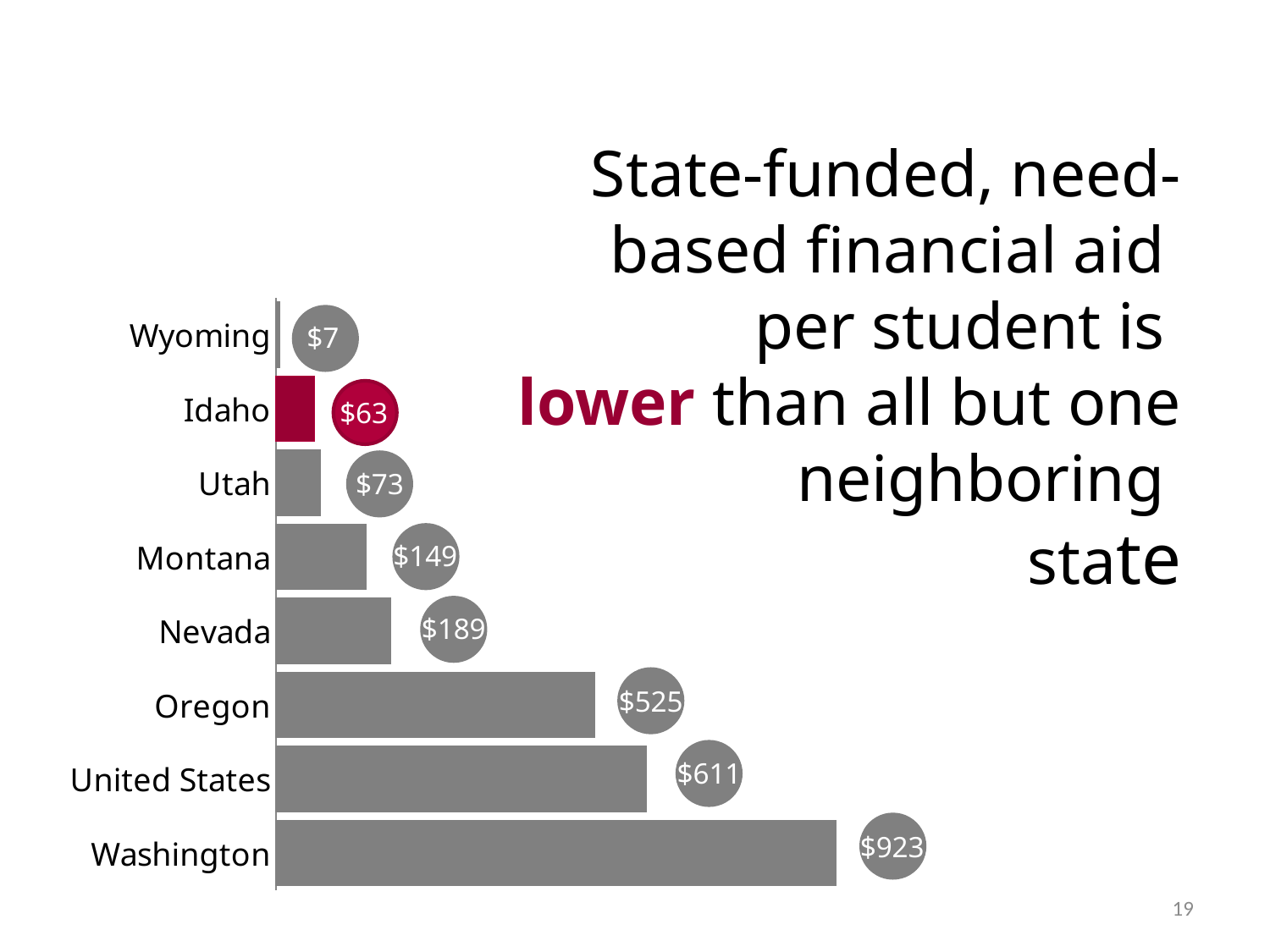
Which bar is highlighted in a different colour from the others? Idaho How many categories are shown in the chart? 8 Which is larger, the value for Utah or the value for Idaho? Utah What is the value for the United States? $611 What kind of chart is shown on the slide? Bar chart Which category has the highest value? Washington What is the difference between the values for Oregon and Nevada? $336 Which category has the lowest value? Wyoming What is the value for Washington? $923 What is the difference between the values for Washington and Idaho? $860 What is the value for Montana? $149 What is the value for Idaho? $63